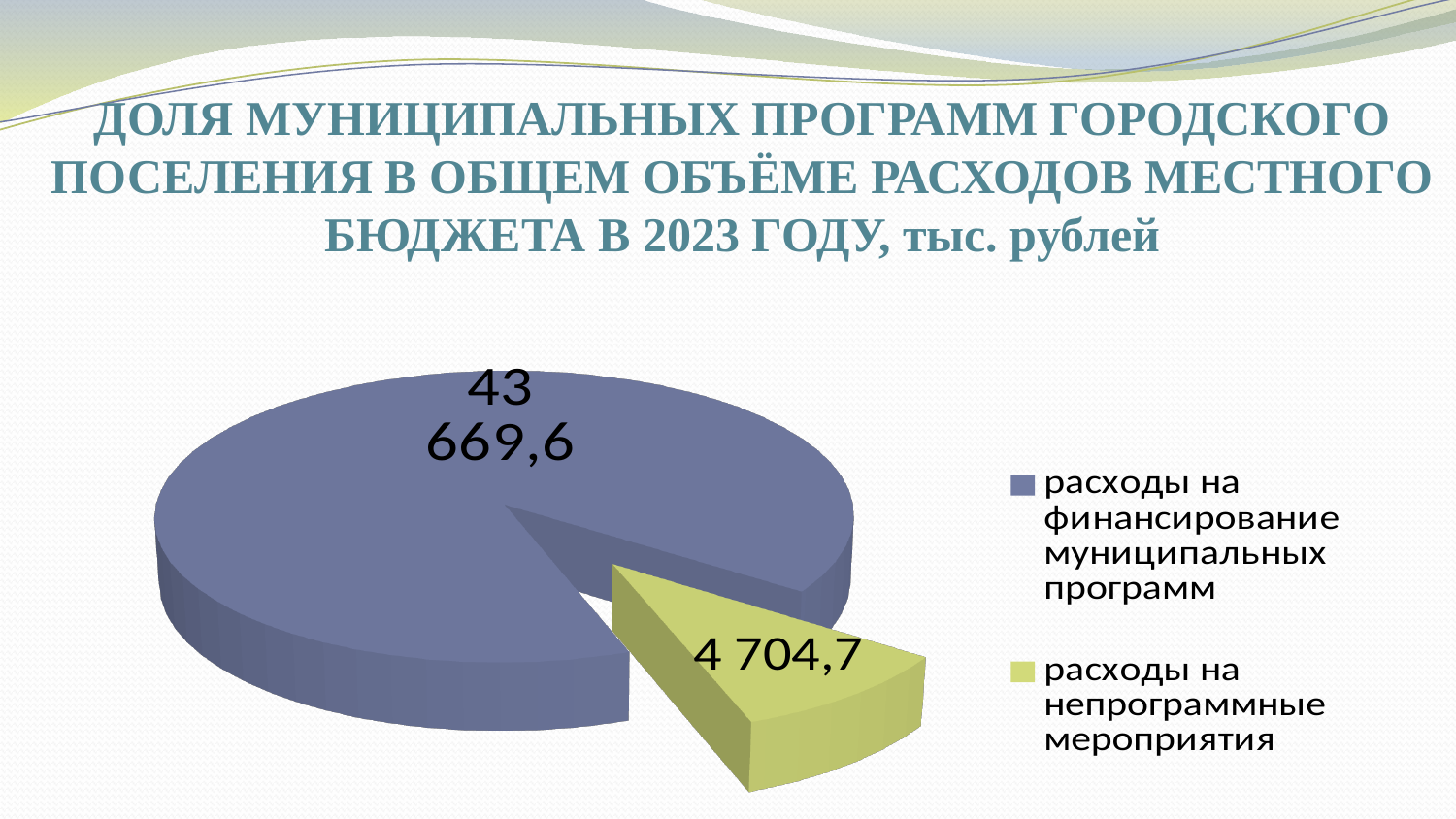
Which is larger: расходы на финансирование муниципальных программ or расходы на непрограммные мероприятия? расходы на финансирование муниципальных программ What is the difference between расходы на финансирование муниципальных программ and расходы на непрограммные мероприятия? 38 964,9 Which category has the smallest slice of the pie? расходы на непрограммные мероприятия What kind of chart is shown on the slide? pie chart What is the total of the two slices in the pie chart? 48 374,3 What share of the pie does расходы на финансирование муниципальных программ represent, to one decimal place? 90.3% How many entries does the legend list? 2 What is the value for расходы на непрограммные мероприятия? 4 704,7 What unit is stated in the chart title? тыс. рублей How many slices does the pie chart have? 2 Which category has the largest slice of the pie? расходы на финансирование муниципальных программ What is the value for расходы на финансирование муниципальных программ? 43 669,6